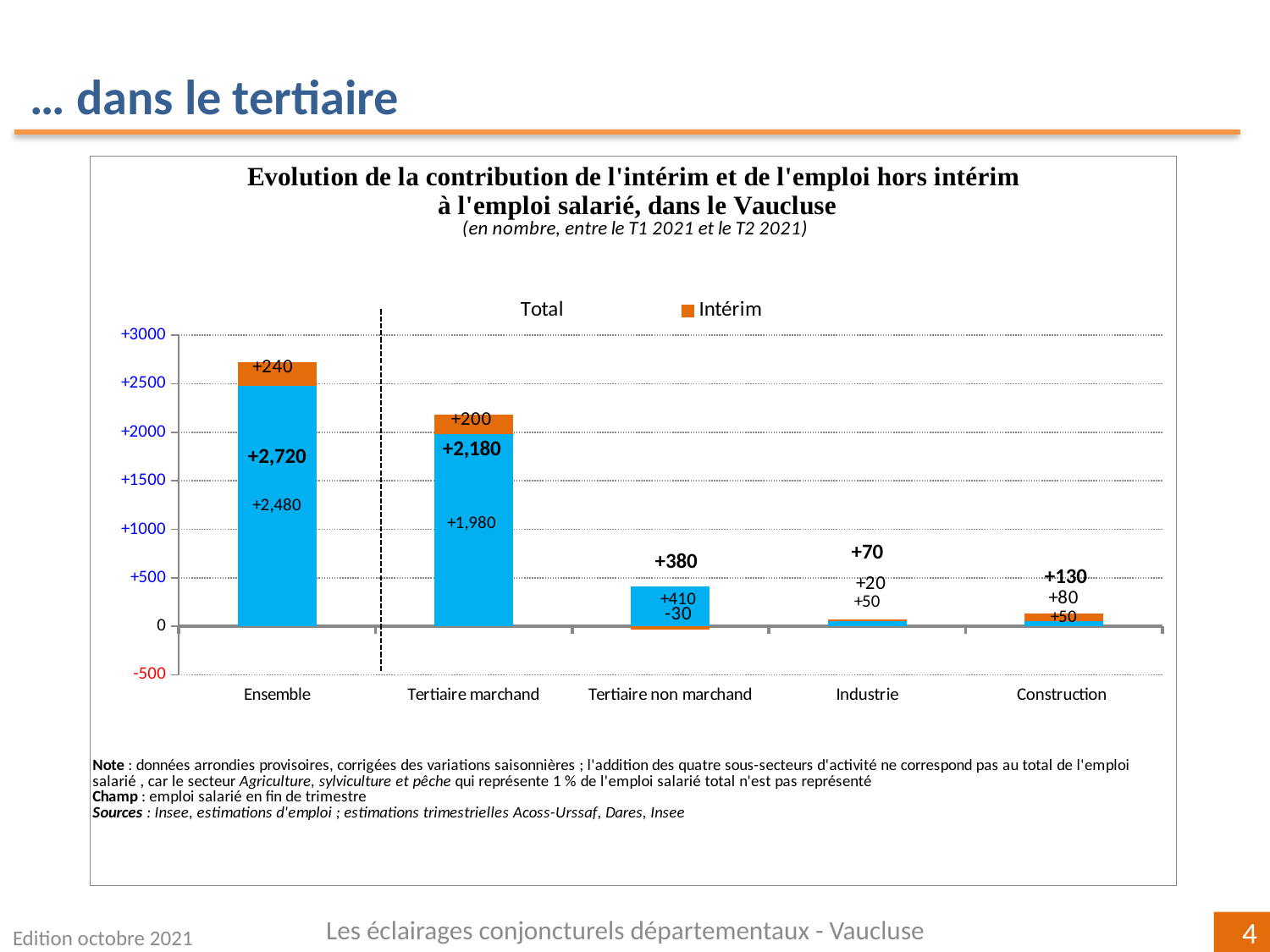
Is the total value for Tertiaire non marchand greater or less than +500? less What is the Intérim value for Tertiaire non marchand? -30 What is the difference between the total for Ensemble and the total for Tertiaire marchand? 540 Which category has the lowest total value? Industrie Which is larger, the Intérim value for Construction or the Intérim value for Industrie? Construction What is the total value shown for Tertiaire marchand? +2,180 How many categories are shown on the x axis? 5 Which category has the highest total value? Ensemble What kind of chart is this? Stacked bar chart What is the Intérim value for Ensemble? +240 What colour represents the Intérim series? Orange What is the total value shown for Construction? +130